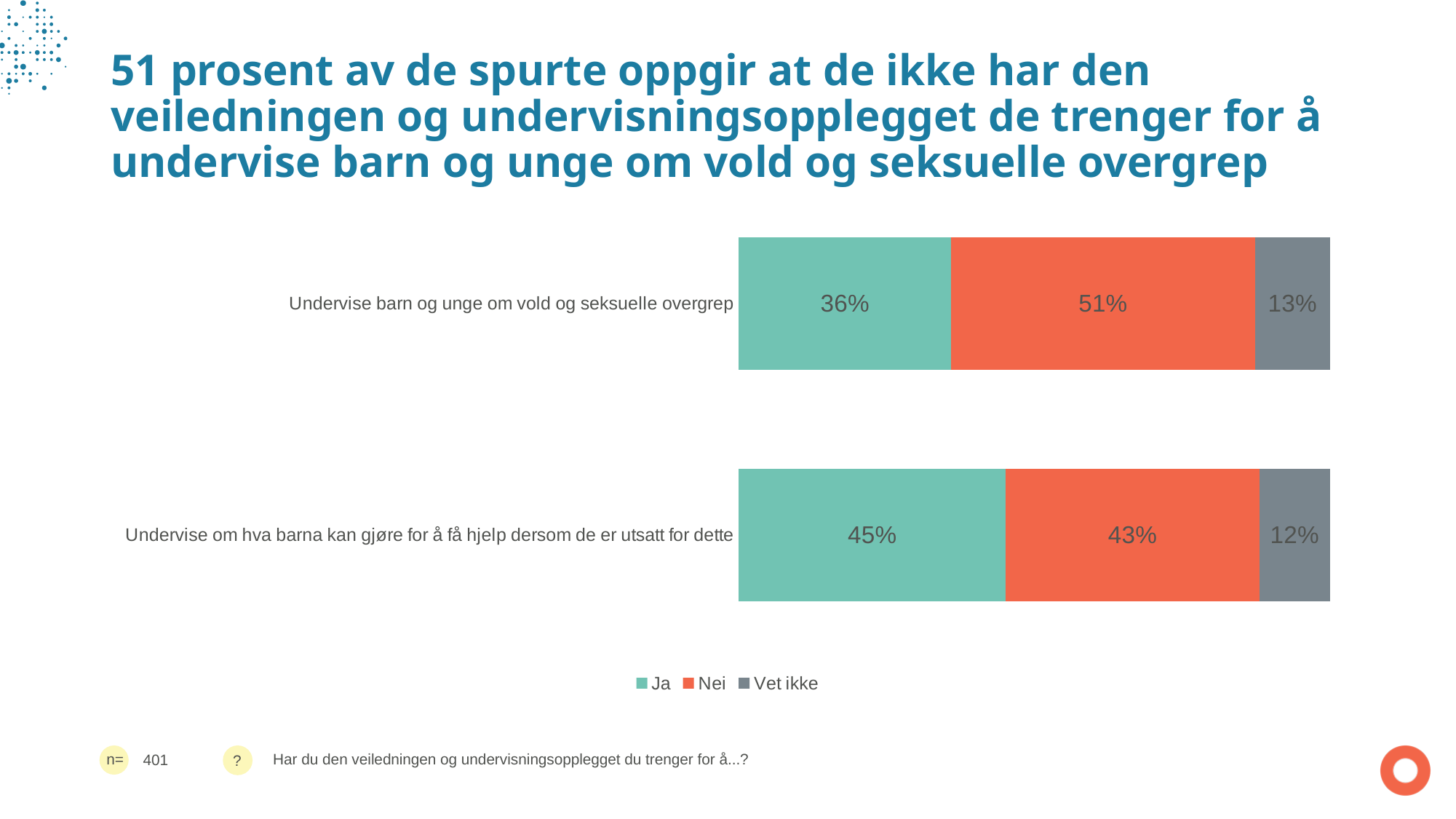
What percentage answered "Nei" for "Undervise barn og unge om vold og seksuelle overgrep"? 51% Which category has the lower "Nei" share? Undervise om hva barna kan gjøre for å få hjelp dersom de er utsatt for dette What is the difference between the "Nei" and "Ja" shares for "Undervise barn og unge om vold og seksuelle overgrep"? 15 percentage points What percentage answered "Ja" for "Undervise om hva barna kan gjøre for å få hjelp dersom de er utsatt for dette"? 45% What percentage answered "Vet ikke" for "Undervise om hva barna kan gjøre for å få hjelp dersom de er utsatt for dette"? 12% How many series does the legend list? 3 What kind of chart is shown on the slide? Stacked bar chart For "Undervise om hva barna kan gjøre for å få hjelp dersom de er utsatt for dette", is the "Ja" share or the "Nei" share larger? Ja Which category has the higher "Ja" share? Undervise om hva barna kan gjøre for å få hjelp dersom de er utsatt for dette How many categories are shown in the chart? 2 What percentage answered "Vet ikke" for "Undervise barn og unge om vold og seksuelle overgrep"? 13% What are the legend entries of the chart? Ja, Nei, Vet ikke